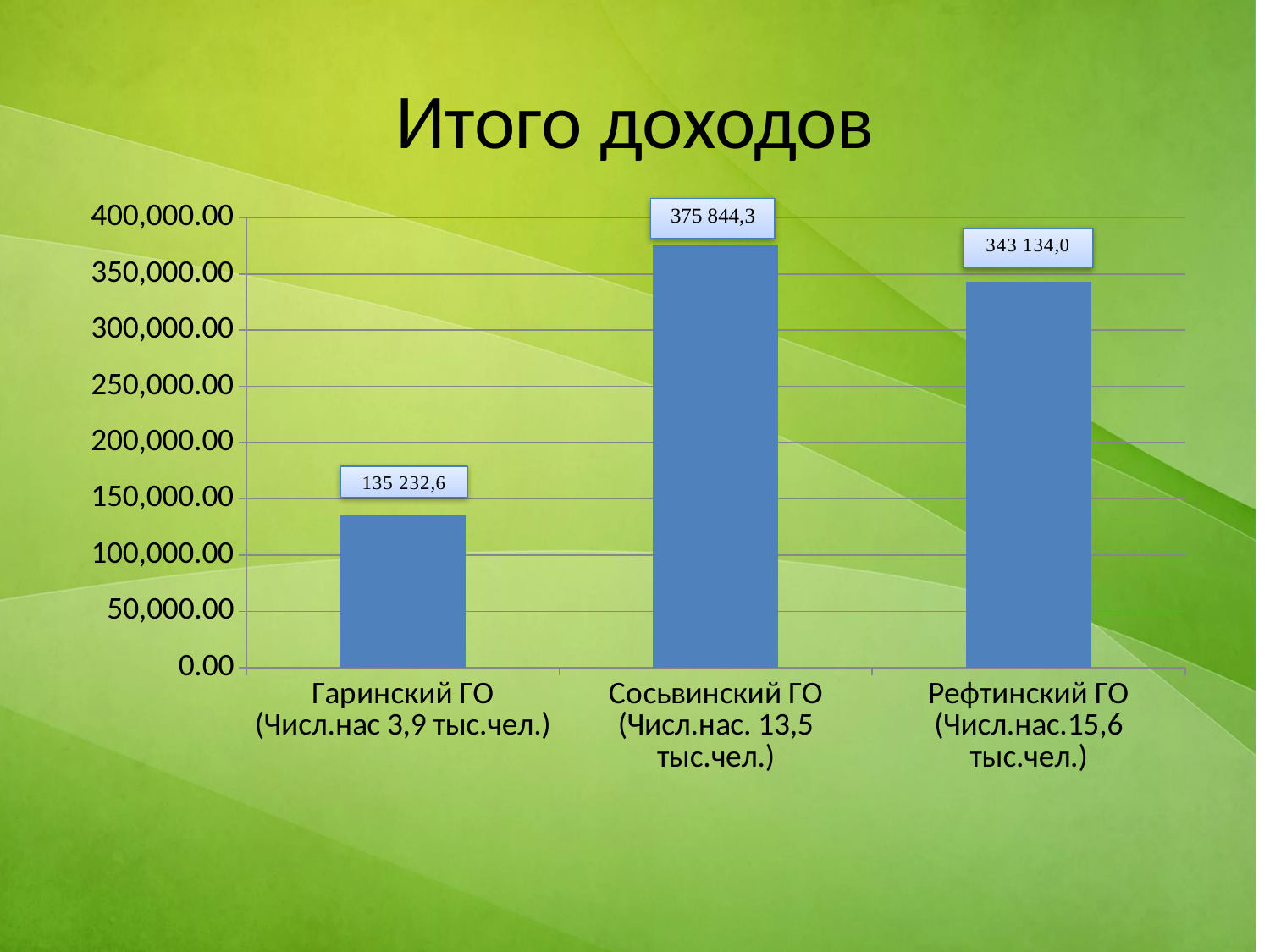
Is the value for Рефтинский ГО greater or less than 350,000.00? less What is the title of the chart? Итого доходов What kind of chart is shown on the slide? bar chart Which is larger, the value for Рефтинский ГО or the value for Гаринский ГО? Рефтинский ГО Which category has the highest value? Сосьвинский ГО What is the difference between the values for Сосьвинский ГО and Рефтинский ГО? 32 710,3 What is the value shown for Гаринский ГО? 135 232,6 What is the difference between the values for Рефтинский ГО and Гаринский ГО? 207 901,4 What is the value shown for Сосьвинский ГО? 375 844,3 Which category has the lowest value? Гаринский ГО How many categories are shown on the chart? 3 What is the value shown for Рефтинский ГО? 343 134,0